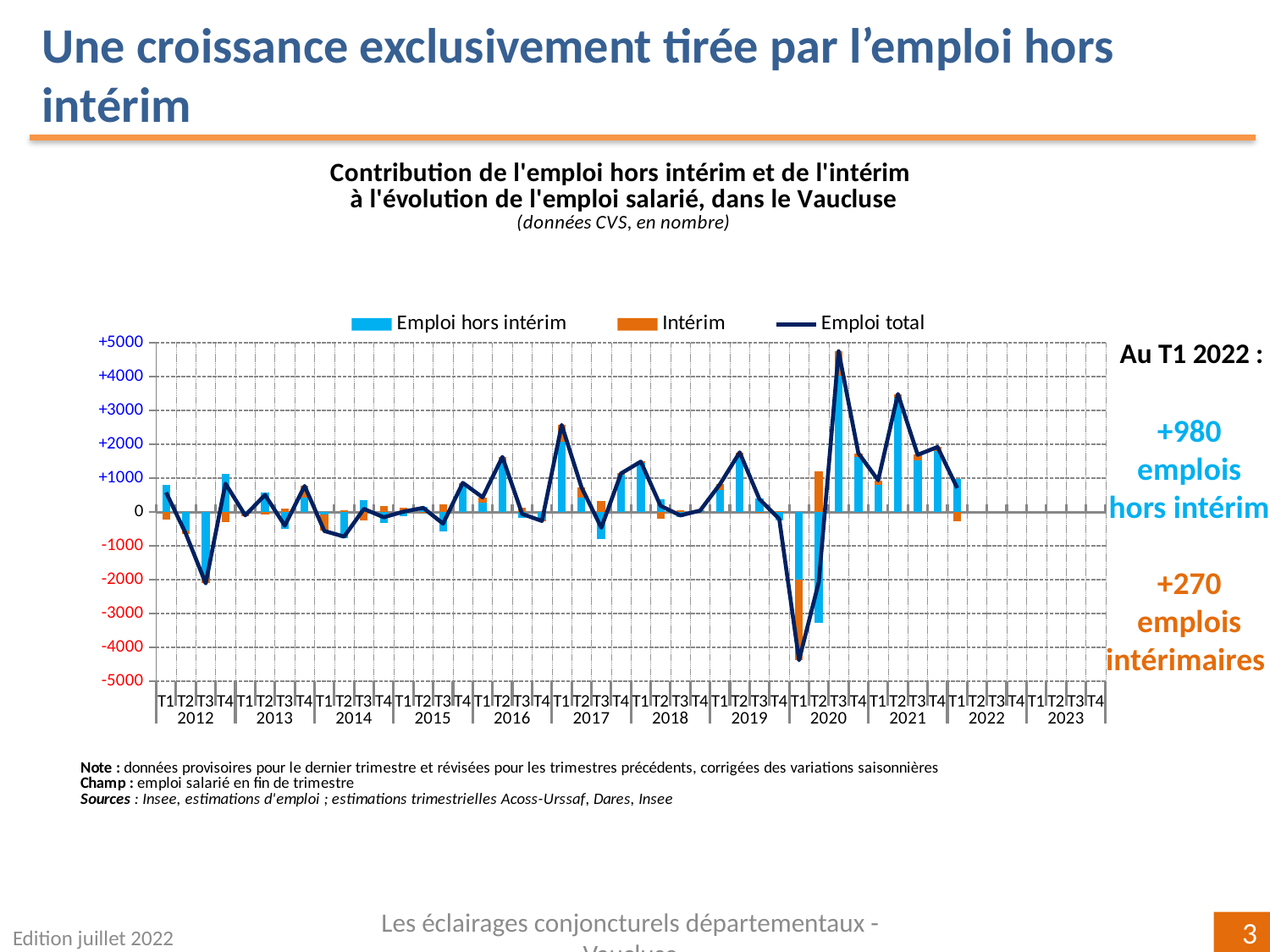
According to the slide, what is the value for 'emplois intérimaires' at T1 2022? +270 Which is larger, the 'Emploi hors intérim' bar at T3 2020 or at T1 2021? T3 2020 At T1 2022, how much larger is the 'emplois hors intérim' figure than the 'emplois intérimaires' figure? 710 What kind of chart is shown on the slide? A combined bar and line chart In which quarter does the 'Emploi total' line reach its lowest value? T1 2020 According to the slide, what is the value for 'emplois hors intérim' at T1 2022? +980 Is the value of the 'Emploi total' line at T1 2020 greater or less than -3000? less How many series does the chart legend list? 3 In which quarter does the 'Emploi total' line reach its highest value? T3 2020 Is the 'Emploi hors intérim' bar at T3 2012 greater or less than -1000? less What colour represents the 'Intérim' series in the chart? Orange Is the value of the 'Emploi total' line at T3 2020 greater or less than +4000? greater